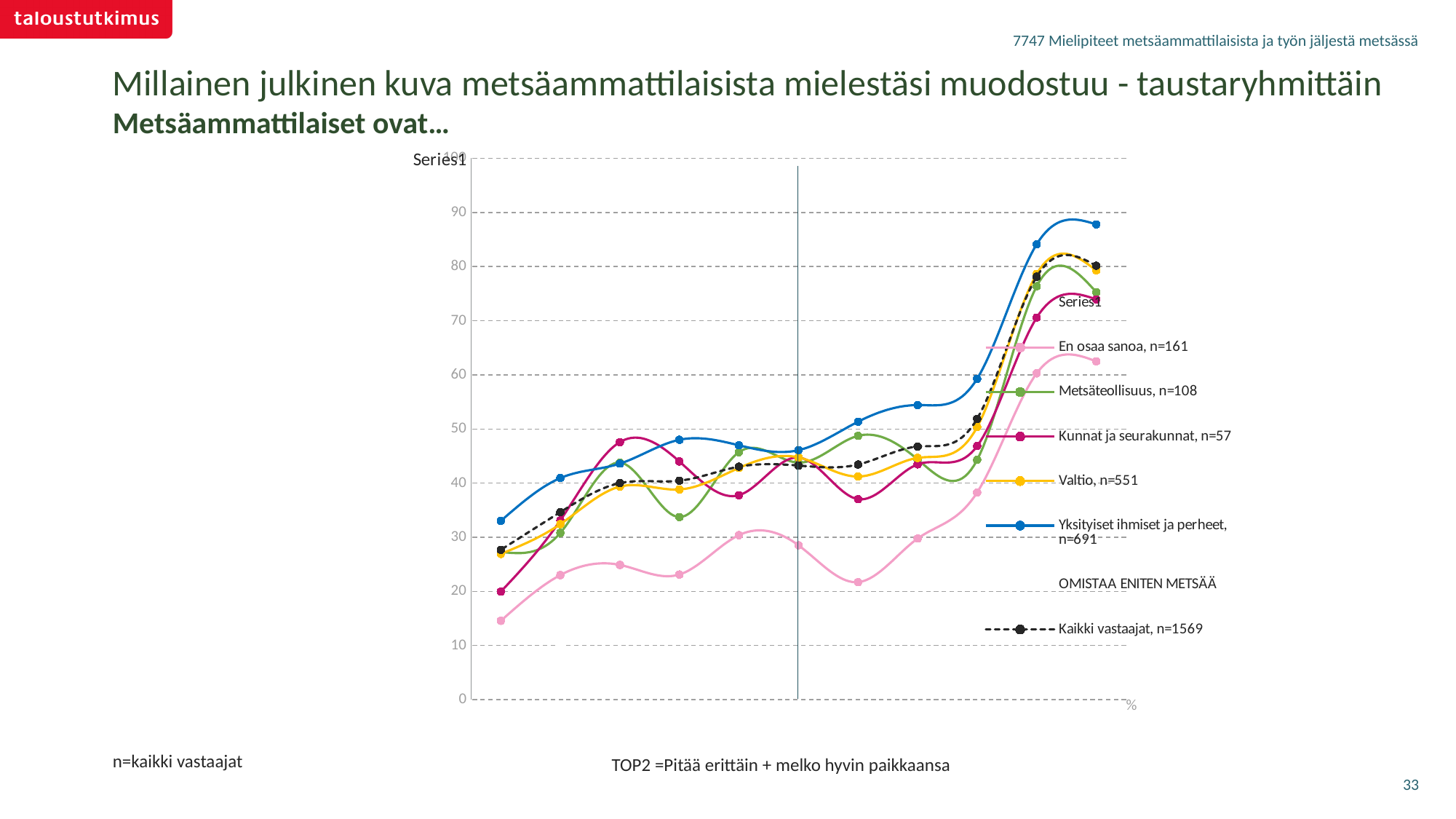
Which series has the highest value at the last point on the x axis? Yksityiset ihmiset ja perheet, n=691 What kind of chart is shown on the slide? line chart Is the value of the last point of the Yksityiset ihmiset ja perheet series greater or less than 80? greater At the first point on the x axis, which is larger: the Yksityiset ihmiset ja perheet series or the En osaa sanoa series? Yksityiset ihmiset ja perheet Which series has the lowest value at the first point on the x axis? En osaa sanoa, n=161 How many data points does the Yksityiset ihmiset ja perheet series have? 11 Do the values of the Kaikki vastaajat series generally rise or fall along the x axis? rise Which series is drawn with a dashed black line? Kaikki vastaajat, n=1569 Is the value of the first point of the Kunnat ja seurakunnat series greater or less than 30? less Is the value of the first point of the En osaa sanoa series greater or less than 20? less What sample size (n) does the legend give for the Valtio series? n=551